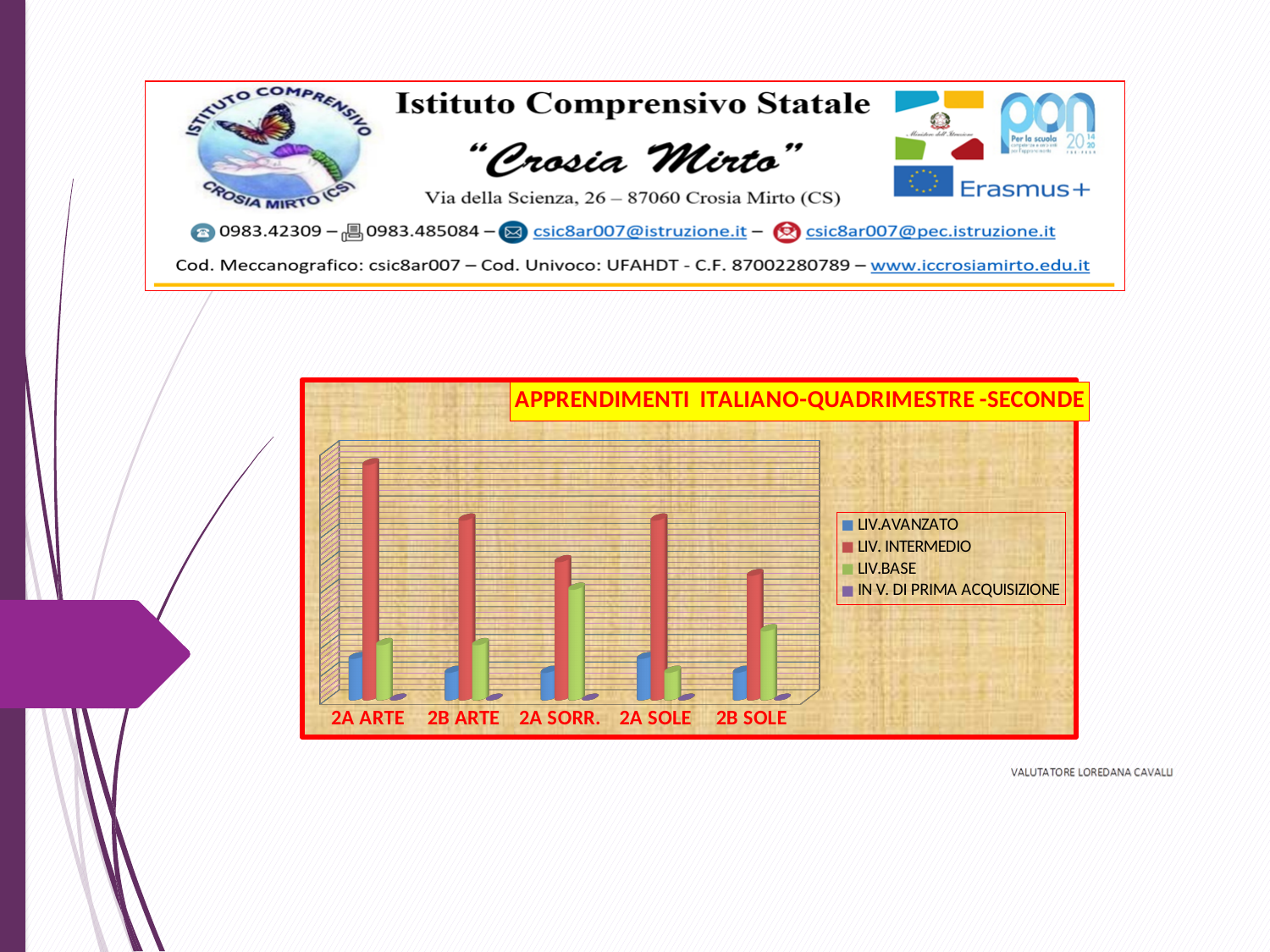
Which series has the smallest bars across all classes? IN V. DI PRIMA ACQUISIZIONE Is the LIV.BASE bar larger for 2A SORR. or for 2A SOLE? 2A SORR. Which class has the lowest LIV. INTERMEDIO bar? 2B SOLE What kind of chart is shown on the slide? Bar chart How many classes (categories) are shown on the x axis of the chart? 5 What is the title of the chart? APPRENDIMENTI ITALIANO-QUADRIMESTRE -SECONDE Which class has the highest LIV.BASE bar? 2A SORR. How many series does the chart legend list? 4 Which series has the tallest bar for 2A ARTE? LIV. INTERMEDIO Which class has the highest LIV. INTERMEDIO bar? 2A ARTE Is the LIV. INTERMEDIO bar larger for 2A ARTE or for 2A SORR.? 2A ARTE Which series is listed last in the chart legend? IN V. DI PRIMA ACQUISIZIONE